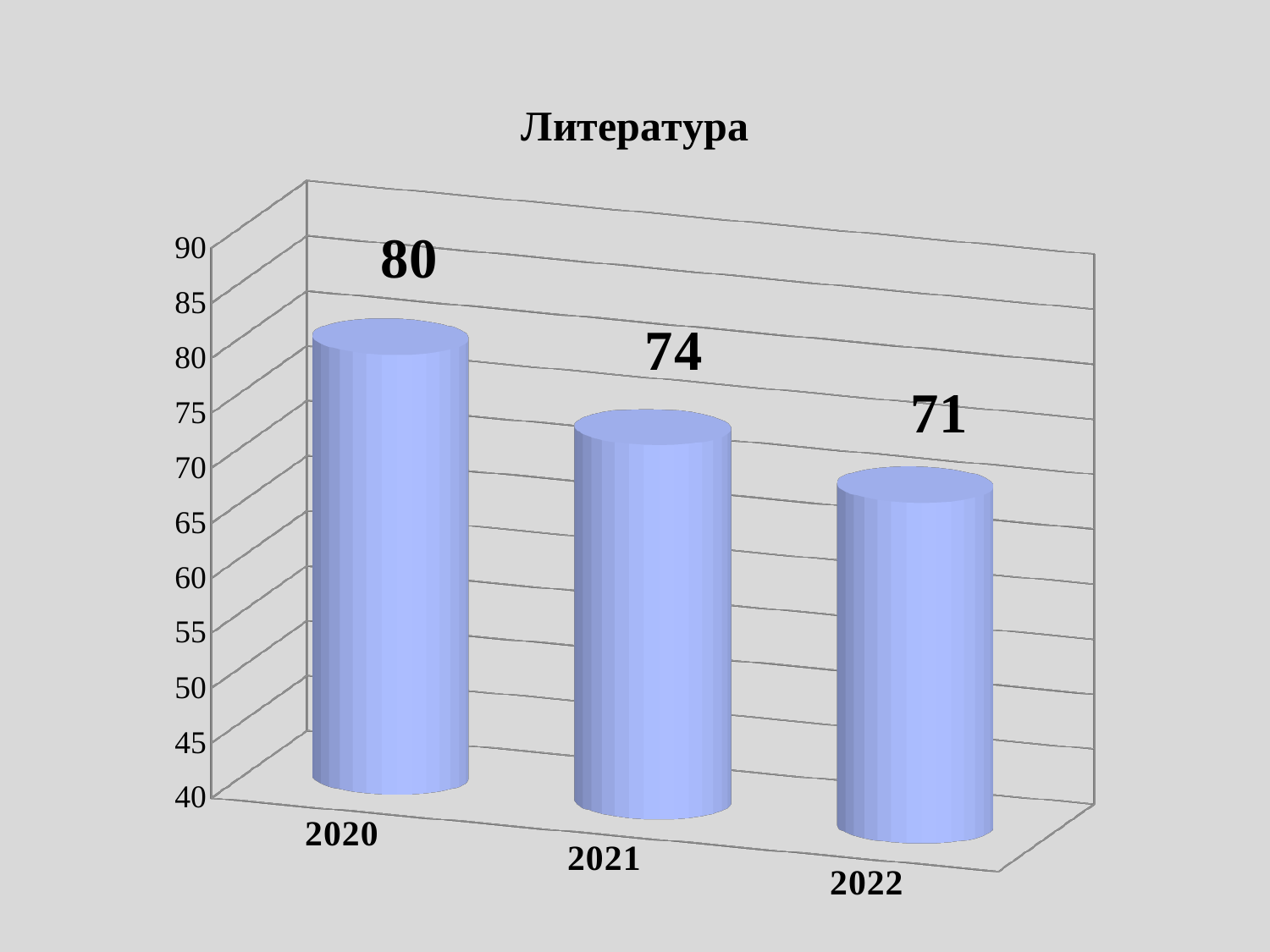
What is the title of the chart? Литература What is the value for 2022? 71 What kind of chart is this? bar chart What is the value for 2020? 80 Which year has the highest value? 2020 What is the difference between the values for 2021 and 2022? 3 What is the difference between the values for 2020 and 2022? 9 What is the value for 2021? 74 Which is larger, the value for 2020 or the value for 2021? 2020 How many years are shown on the chart? 3 Do the values rise or fall from 2020 to 2022? fall Which year has the lowest value? 2022